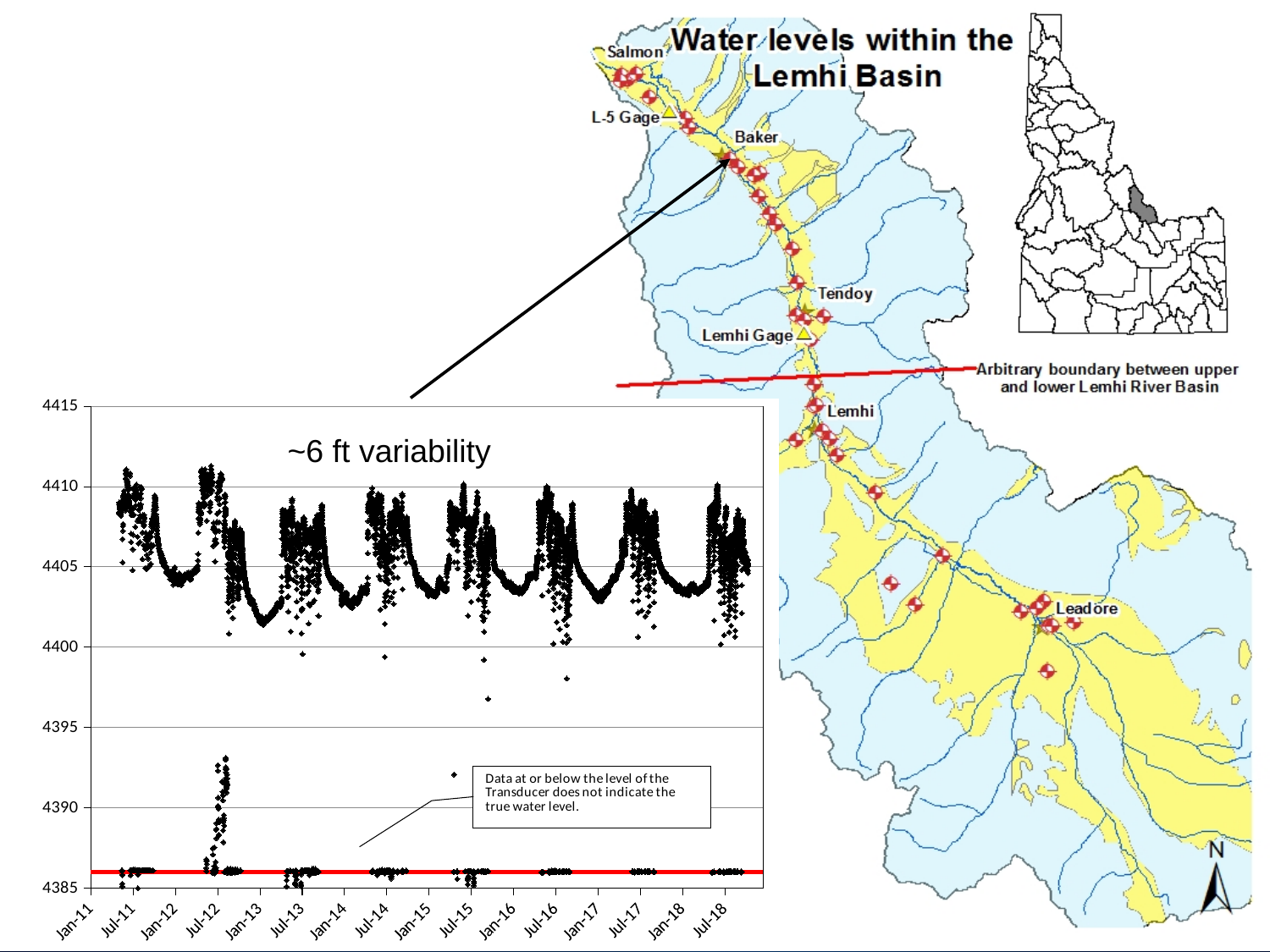
What is the first date label on the x-axis of the water level chart? Jan-11 On the water level chart, is the top of the isolated spike near Jul-12 greater or less than 4395? less What is the highest value shown on the y-axis of the water level chart? 4415 What kind of chart is the water level chart on the left of the slide? scatter chart On the water level chart, are the peak values around Jul-17 greater or less than 4395? greater What variability is stated in the annotation on the water level chart? ~6 ft variability On the water level chart, is the lowest isolated point near Jul-15 greater or less than 4400? less How many date labels are shown along the x-axis of the water level chart? 16 What is the last date label on the x-axis of the water level chart? Jul-18